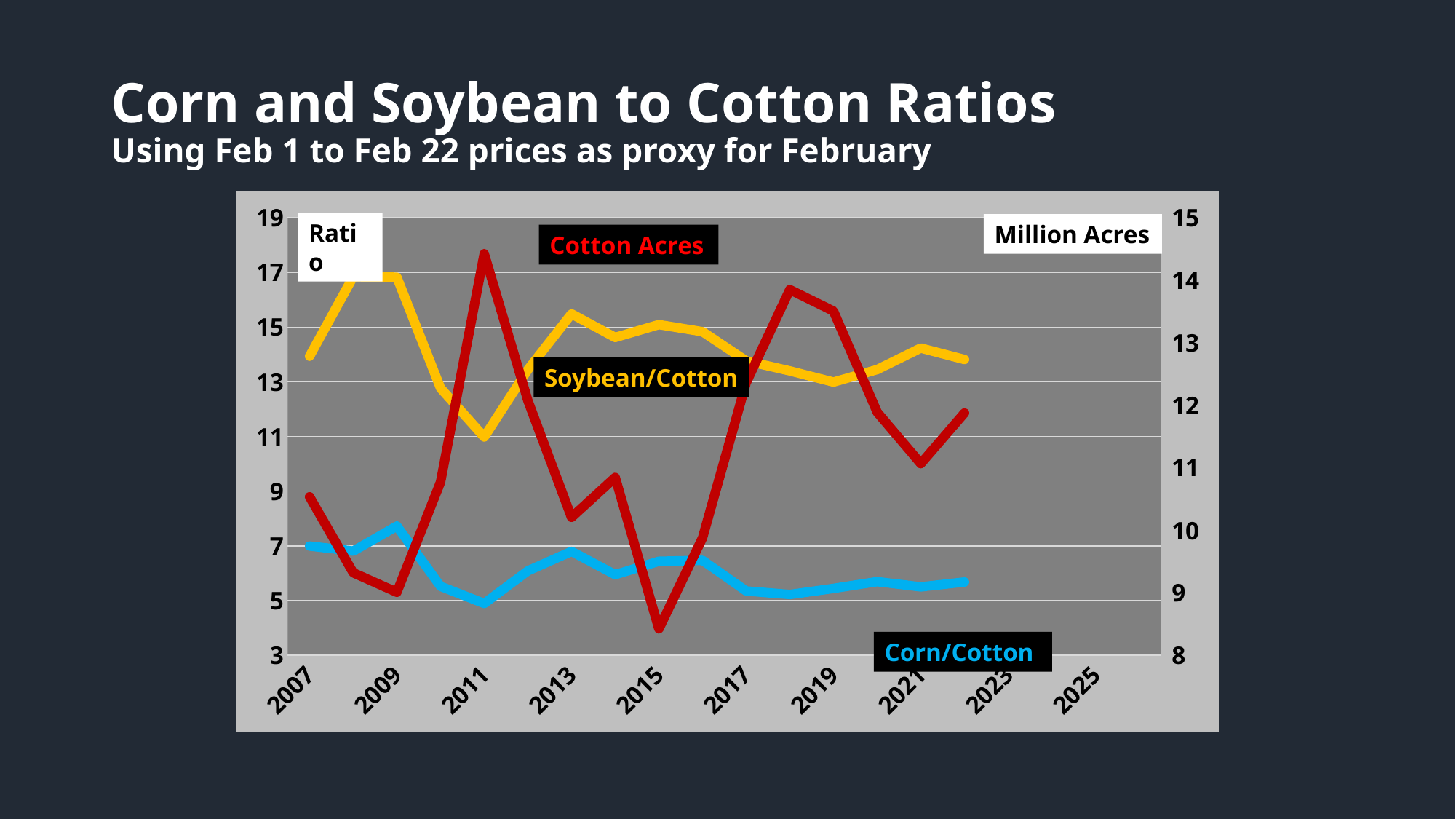
Is the Cotton Acres value in 2015 greater or less than 9 million acres? less What kind of chart is shown on the slide? line chart In which year does the Cotton Acres series reach its lowest value? 2015 In 2009, which is higher, the Soybean/Cotton ratio or the Corn/Cotton ratio? Soybean/Cotton Does the Soybean/Cotton ratio rise or fall from 2009 to 2011? fall What is the title of the chart on the slide? Corn and Soybean to Cotton Ratios What is the label of the right-hand vertical axis? Million Acres How many data series are plotted on the chart? 3 In which year does the Cotton Acres series reach its highest value? 2011 In which year does the Corn/Cotton ratio reach its highest value? 2009 Is the Soybean/Cotton ratio in 2011 greater or less than 13? less Is the Corn/Cotton ratio in 2007 greater or less than 9? less